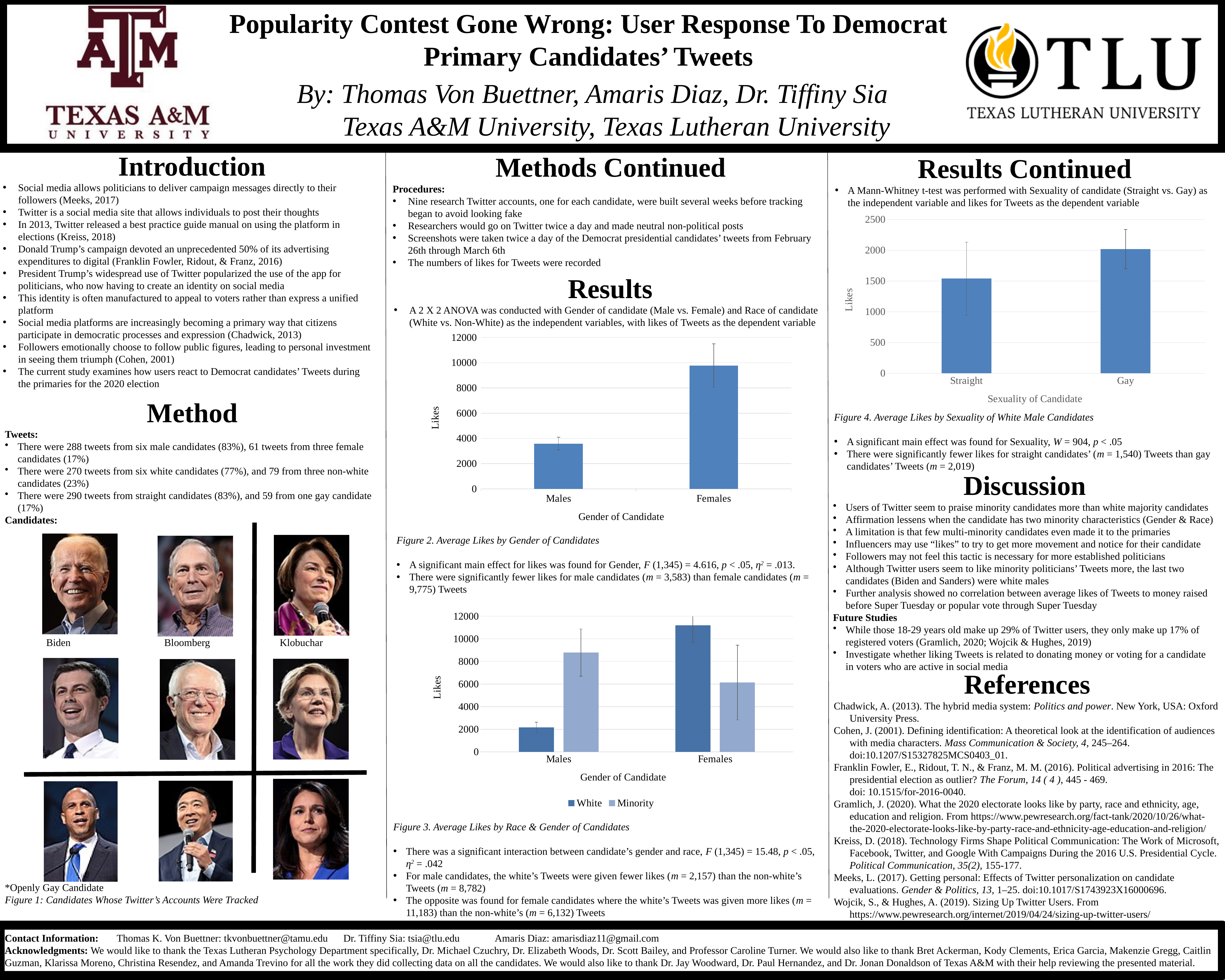
In Figure 3 (Average Likes by Race & Gender of Candidates), is the White value for Females greater or less than 10000? greater In Figure 3 (Average Likes by Race & Gender of Candidates), for Females, which series has the larger value, White or Minority? White In Figure 3 (Average Likes by Race & Gender of Candidates), for Males, which series has the larger value, White or Minority? Minority In Figure 2 (Average Likes by Gender of Candidates), is the value for Males greater or less than 4000? less In Figure 3 (Average Likes by Race & Gender of Candidates), what are the two series named in the legend? White and Minority In Figure 4 (Average Likes by Sexuality of White Male Candidates), which category has the lower average likes? Straight In Figure 3 (Average Likes by Race & Gender of Candidates), how many series does the legend list? 2 In Figure 4 (Average Likes by Sexuality of White Male Candidates), what is the label of the x axis? Sexuality of Candidate In Figure 4 (Average Likes by Sexuality of White Male Candidates), is the value for Straight greater or less than 1000? greater In Figure 2 (Average Likes by Gender of Candidates), which gender has the higher average likes? Females In Figure 2 (Average Likes by Gender of Candidates), what kind of chart is shown? bar chart